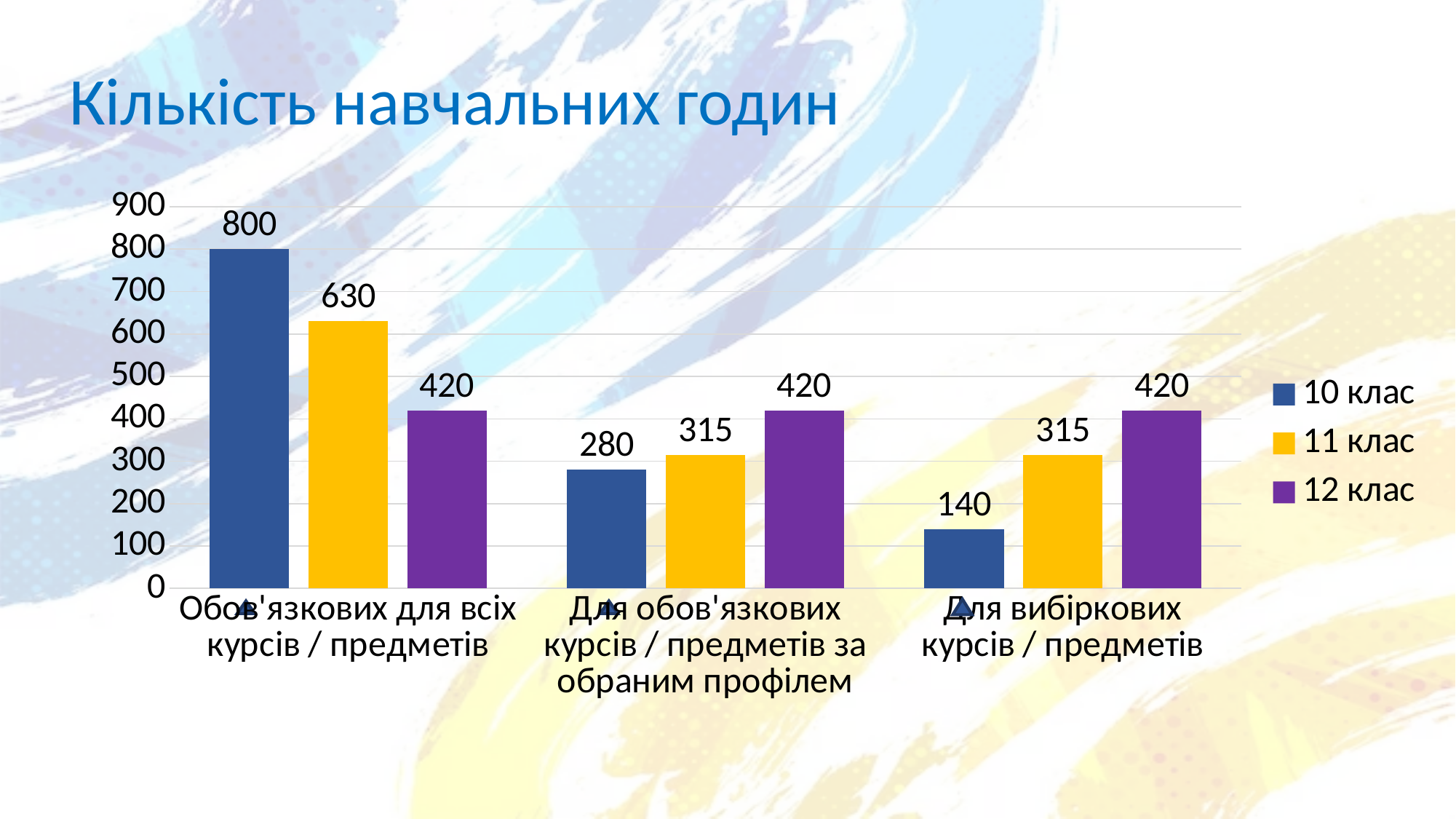
What is the value for 11 клас in the category Для обов'язкових курсів / предметів за обраним профілем? 315 What is the title of the chart? Кількість навчальних годин Is the value for 11 клас in the category Обов'язкових для всіх курсів / предметів greater or less than 600? greater What is the difference between the 10 клас and 11 клас values in the category Обов'язкових для всіх курсів / предметів? 170 How many categories are shown on the x axis? 3 What is the value for 10 клас in the category Обов'язкових для всіх курсів / предметів? 800 How many series does the legend list? 3 Which category has the highest value for 10 клас? Обов'язкових для всіх курсів / предметів What kind of chart is shown on the slide? bar chart Which is larger in the category Для вибіркових курсів / предметів: the value for 10 клас or for 11 клас? 11 клас Which category has the lowest value for 10 клас? Для вибіркових курсів / предметів What is the value for 12 клас in the category Для вибіркових курсів / предметів? 420